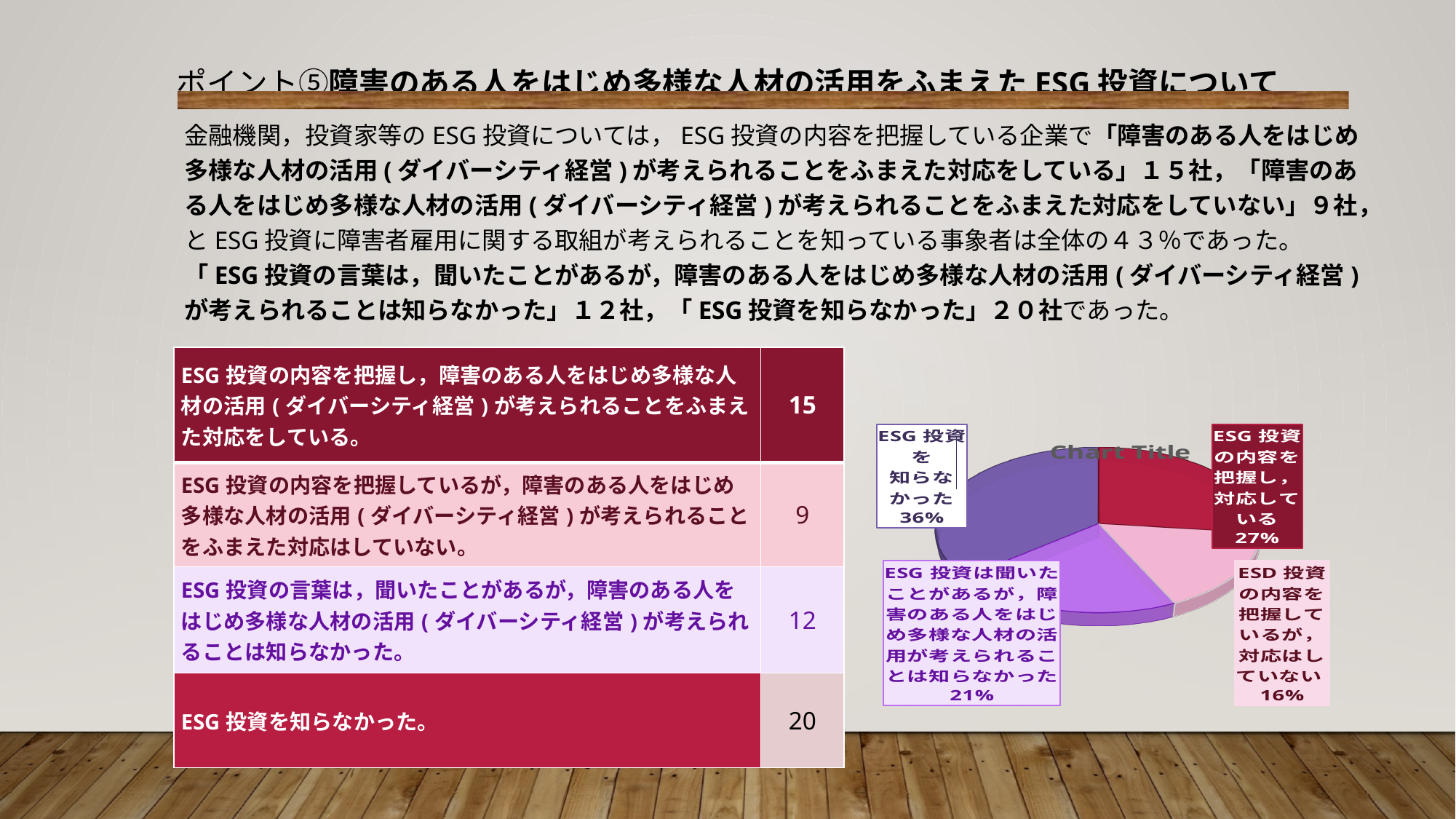
Which slice of the pie chart is the largest? ESG投資を知らなかった Which is larger: the 「ESG投資の内容を把握し，対応している」 slice or the 「ESG投資は聞いたことがあるが…知らなかった」 slice? ESG投資の内容を把握し，対応している What share of the pie is labelled 「ESD投資の内容を把握しているが，対応はしていない」? 16% What colour is the 「ESG投資を知らなかった」 slice of the pie chart? purple What is the difference in percentage points between the 「ESG投資を知らなかった」 slice and the 「ESG投資の内容を把握し，対応している」 slice? 9 Which slice of the pie chart is the smallest? ESD投資の内容を把握しているが，対応はしていない What kind of chart is shown on the slide? pie chart What share of the pie is labelled 「ESG投資は聞いたことがあるが，障害のある人をはじめ多様な人材の活用が考えられることは知らなかった」? 21% What is the chart's title? Chart Title What share of the pie is labelled 「ESG投資の内容を把握し，対応している」? 27% How many slices does the pie chart have? 4